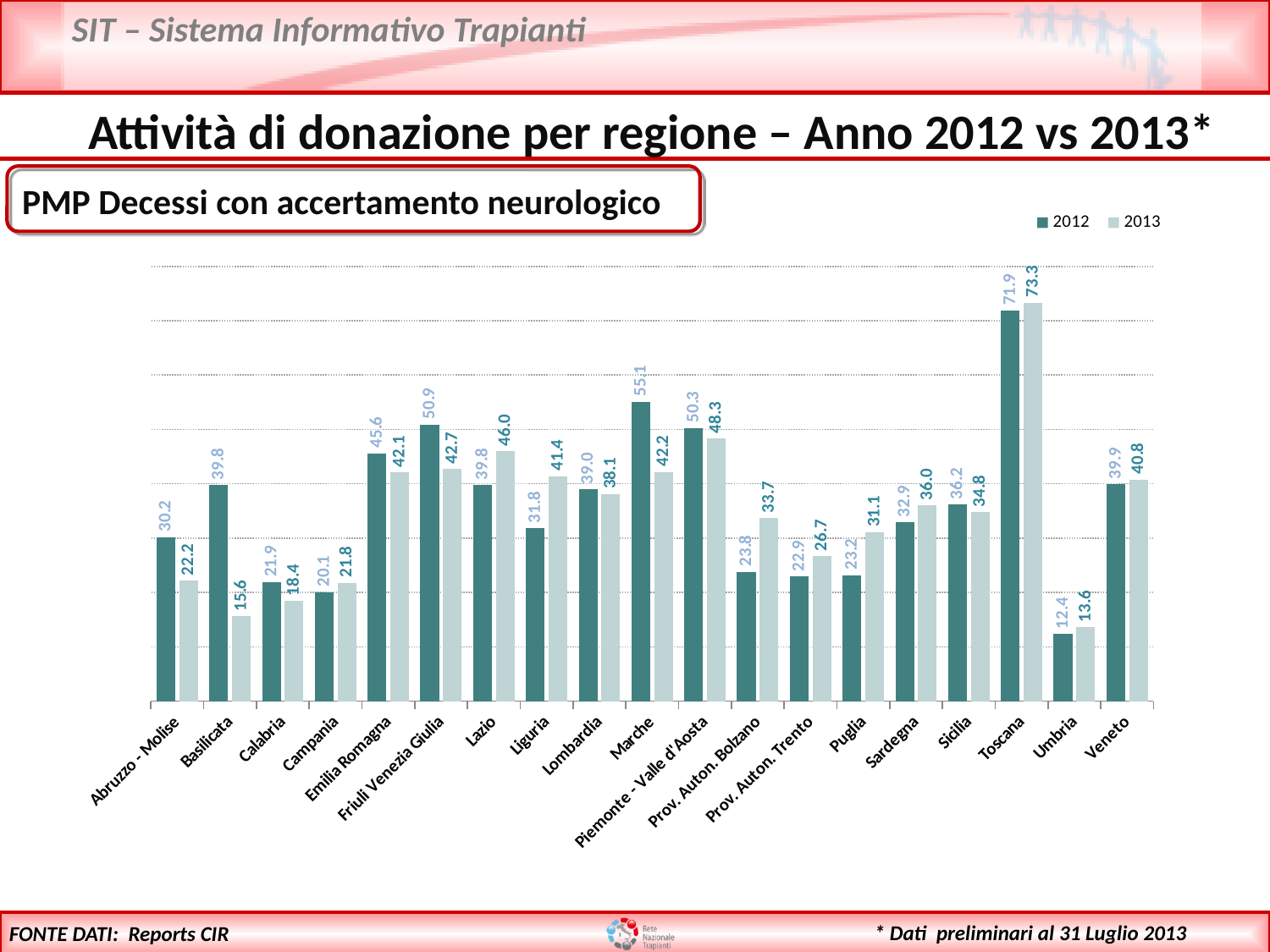
What is the 2013 value for Prov. Auton. Bolzano? 33.7 What is the difference between the 2012 and 2013 values for Basilicata? 24.2 What is the 2012 value for Marche? 55.1 Which region has the highest 2012 value? Toscana How many regions are shown on the x axis? 19 Which region has the lowest 2013 value? Umbria Which is larger for Liguria, the 2012 value or the 2013 value? 2013 What is the 2013 value for Lazio? 46.0 What is the difference between the 2013 and 2012 values for Toscana? 1.4 Which is larger, the 2012 value for Friuli Venezia Giulia or the 2012 value for Piemonte - Valle d'Aosta? Friuli Venezia Giulia How many series does the legend list? 2 What kind of chart is shown on the slide? Bar chart